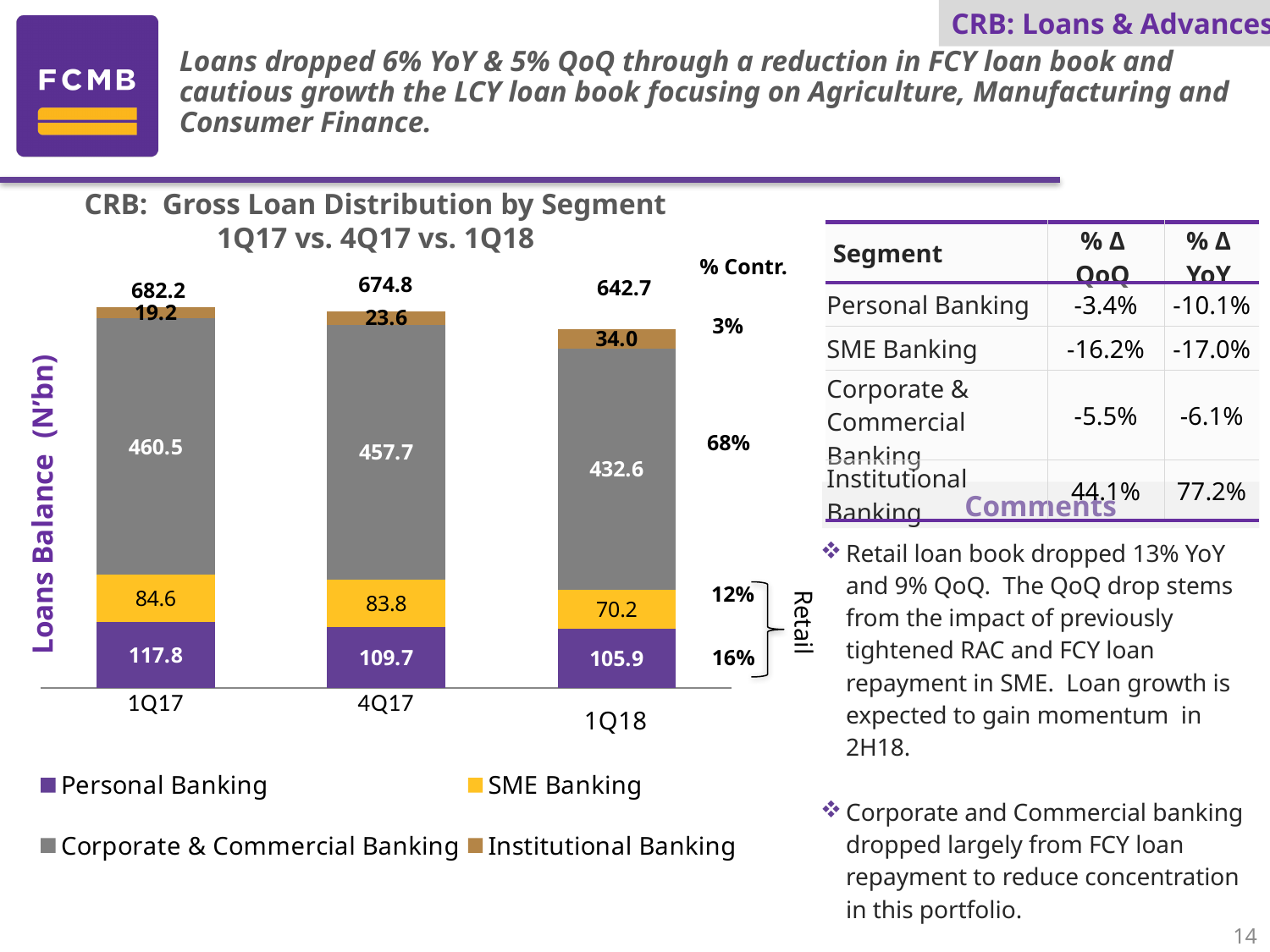
What is the total gross loan balance shown for 1Q18? 642.7 How many series does the chart legend list? 4 Is the Corporate & Commercial Banking balance larger in 4Q17 or in 1Q18? 4Q17 What is the Institutional Banking loan balance in 4Q17? 23.6 What is the Corporate & Commercial Banking loan balance in 1Q18? 432.6 What is the Personal Banking loan balance in 1Q17? 117.8 Which period has the highest total gross loan balance? 1Q17 What is the difference between the total gross loan balance in 1Q17 and 1Q18? 39.5 Which period has the lowest SME Banking loan balance? 1Q18 What kind of chart is used to show the gross loan distribution by segment? Stacked bar chart How many periods are shown on the x axis of the chart? 3 Does the total gross loan balance rise or fall from 1Q17 to 1Q18? Fall